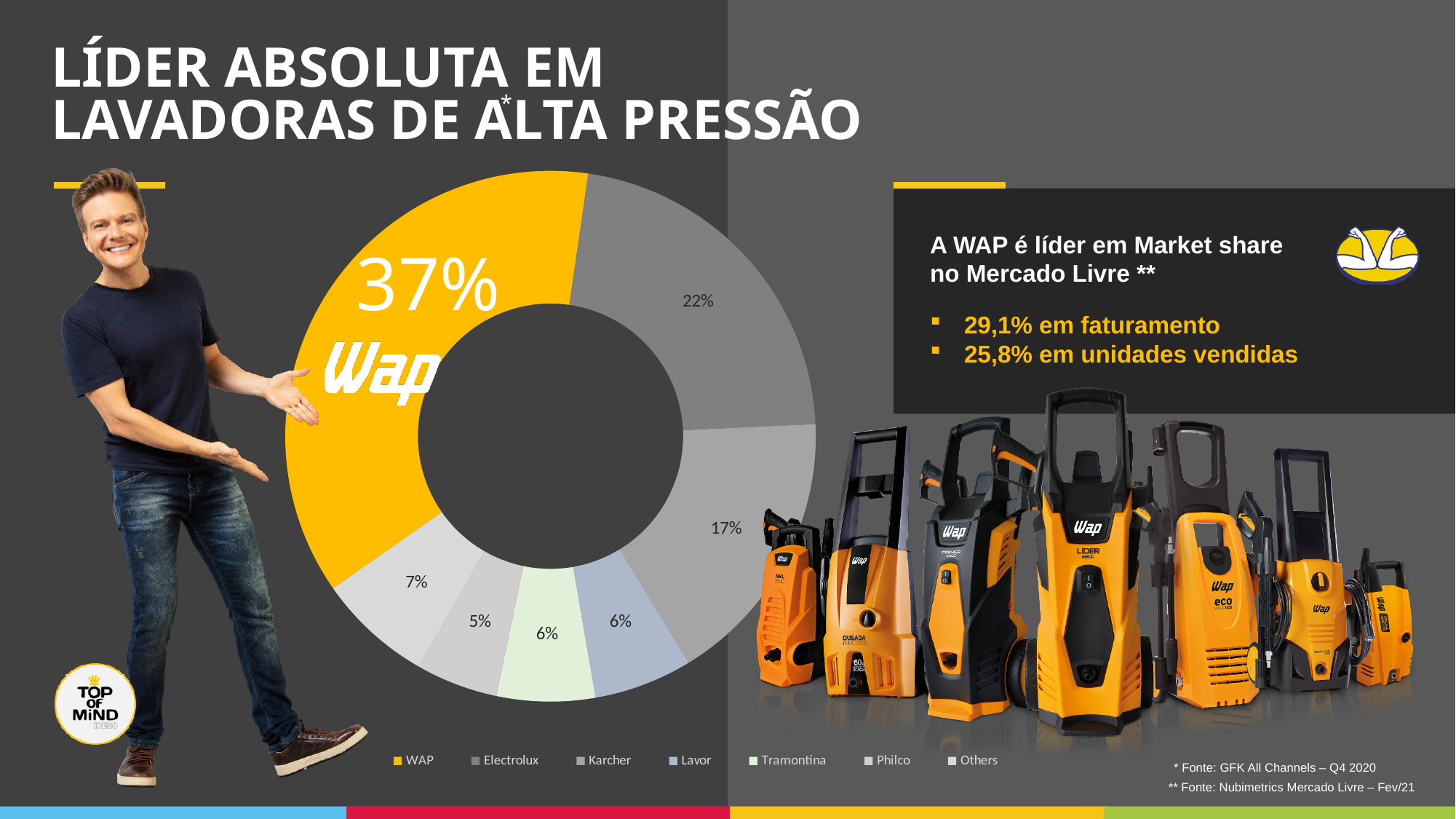
Which brand has the largest slice of the pie chart? WAP What percentage is shown for Electrolux in the pie chart? 22% How many percentage points larger is WAP's share than Electrolux's share? 15 How many brands/categories are shown in the pie chart legend? 7 What share of the pie chart does WAP hold? 37% How many percentage points larger is Electrolux's share than Karcher's share? 5 Which has a larger share in the pie chart, Electrolux or Karcher? Electrolux What percentage is shown for Lavor in the pie chart? 6% What percentage is shown for Tramontina in the pie chart? 6% What type of chart is shown on the slide? Pie (doughnut) chart What percentage is shown for Karcher in the pie chart? 17% What colour is the WAP slice in the pie chart? Yellow